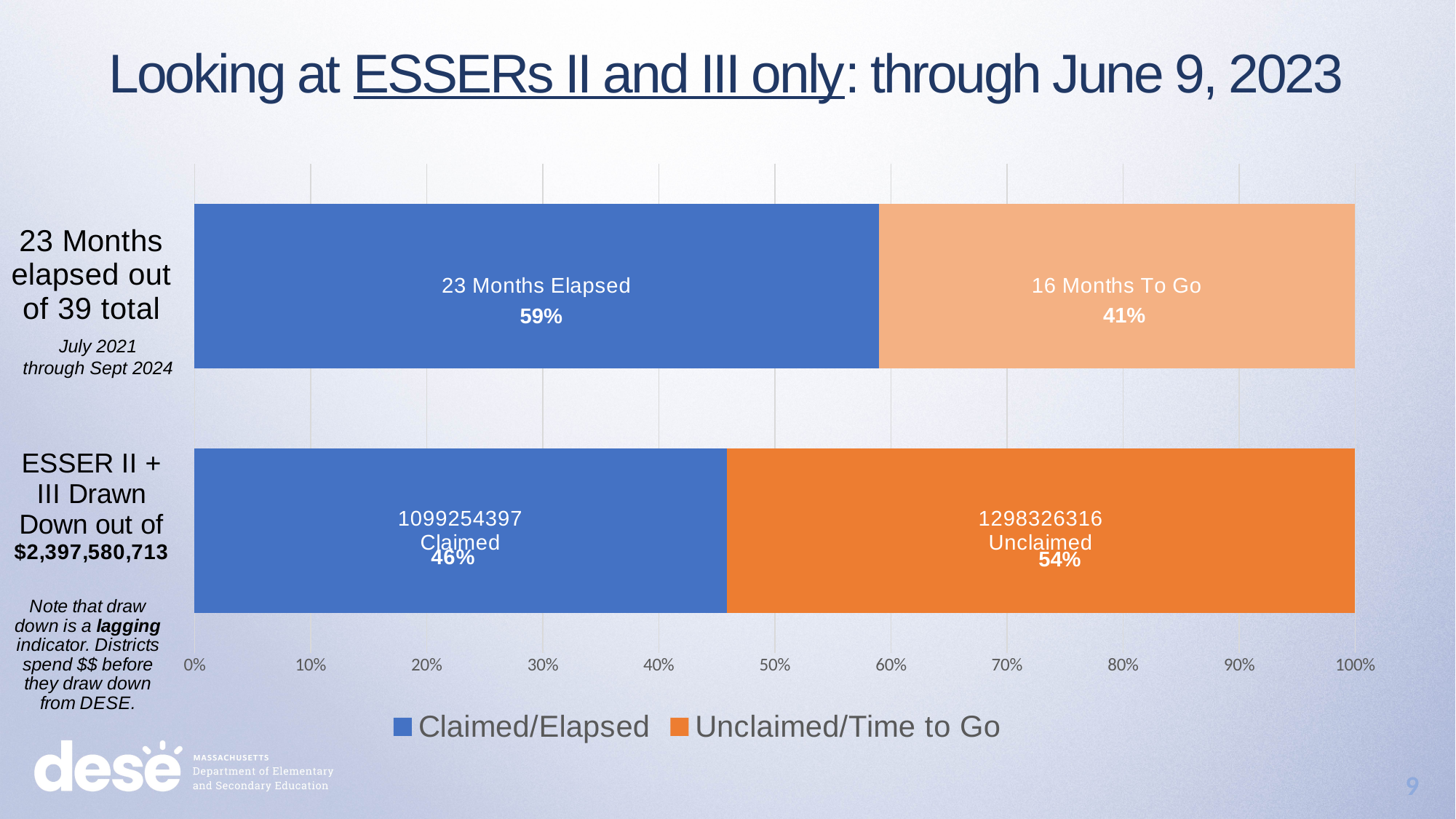
What kind of chart is shown on the slide? Stacked bar chart Which is larger: the percentage of months elapsed or the percentage of funds claimed? Percentage of months elapsed What percentage is labelled '16 Months To Go' in the top bar? 41% What percentage of ESSER II + III funds has been claimed according to the bottom bar? 46% What are the two legend entries shown below the chart? Claimed/Elapsed and Unclaimed/Time to Go How many bars are shown in the chart? 2 What is the dollar amount labelled as Unclaimed in the bottom bar? 1298326316 What percentage of the 39 months has elapsed according to the top bar? 59% What is the difference between the percentage of months elapsed (59%) and the percentage of funds claimed (46%)? 13% How many series does the legend list? 2 What percentage of ESSER II + III funds is unclaimed according to the bottom bar? 54% What is the dollar amount labelled as Claimed in the bottom bar? 1099254397